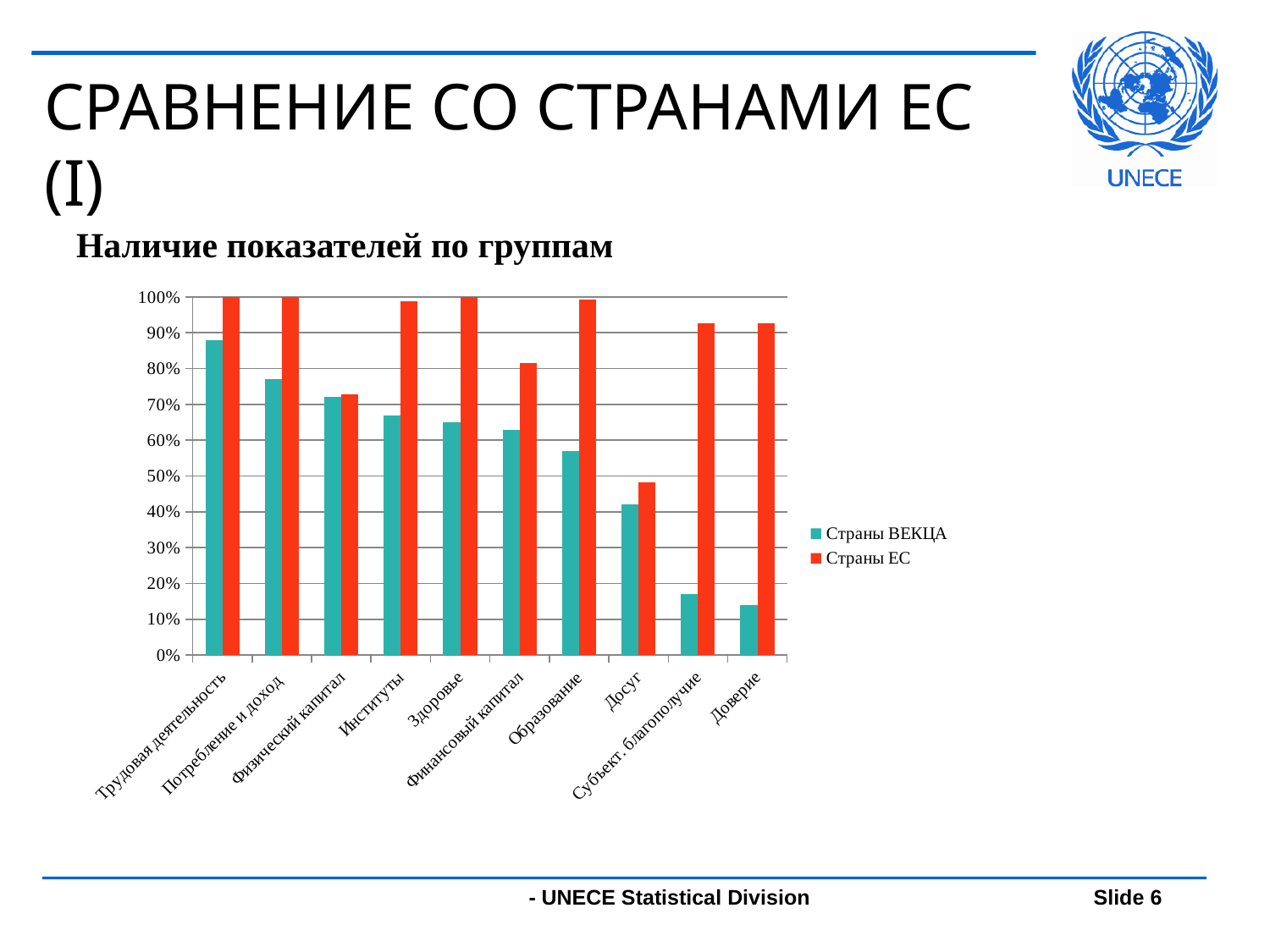
Is the value for Страны ВЕКЦА in Трудовая деятельность greater or less than 80%? greater Which category has the lowest value for Страны ЕС? Досуг What is the title of the chart? Наличие показателей по группам How many series does the legend list? 2 Is the value for Страны ЕС in Досуг greater or less than 50%? less Is the value for Страны ВЕКЦА in Доверие greater or less than 20%? less For Досуг, which series has the larger value, Страны ВЕКЦА or Страны ЕС? Страны ЕС Do the values for Страны ВЕКЦА rise or fall from left to right along the x axis? fall Which category has the highest value for Страны ВЕКЦА? Трудовая деятельность Which category has the lowest value for Страны ВЕКЦА? Доверие How many categories are shown on the x axis? 10 What kind of chart is shown on the slide? bar chart